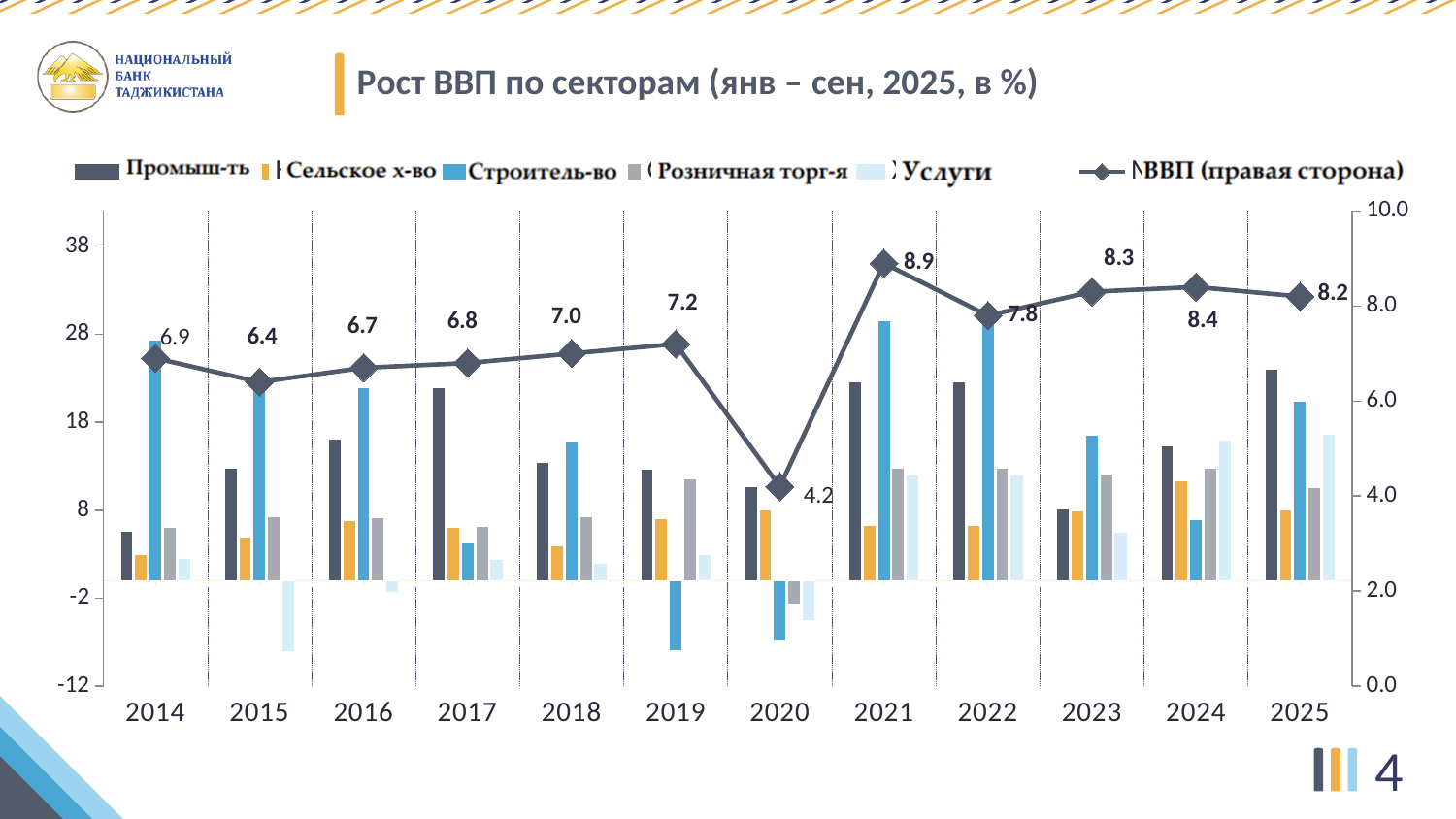
Is the value for Строитель-во in 2014 greater or less than 18? greater How many series does the legend list? 6 What is the ВВП value shown for 2020? 4.2 How many years are shown on the x axis? 12 What is the difference between the ВВП values for 2021 and 2020? 4.7 Is the value for Строитель-во in 2019 greater or less than -2? less What is the ВВП value shown for 2025? 8.2 What is the ВВП value shown for 2021? 8.9 What kind of chart is shown on the slide? Combination bar and line chart In which year is the ВВП line at its lowest? 2020 In which year is the ВВП line at its highest? 2021 Which year has a higher ВВП value, 2023 or 2024? 2024